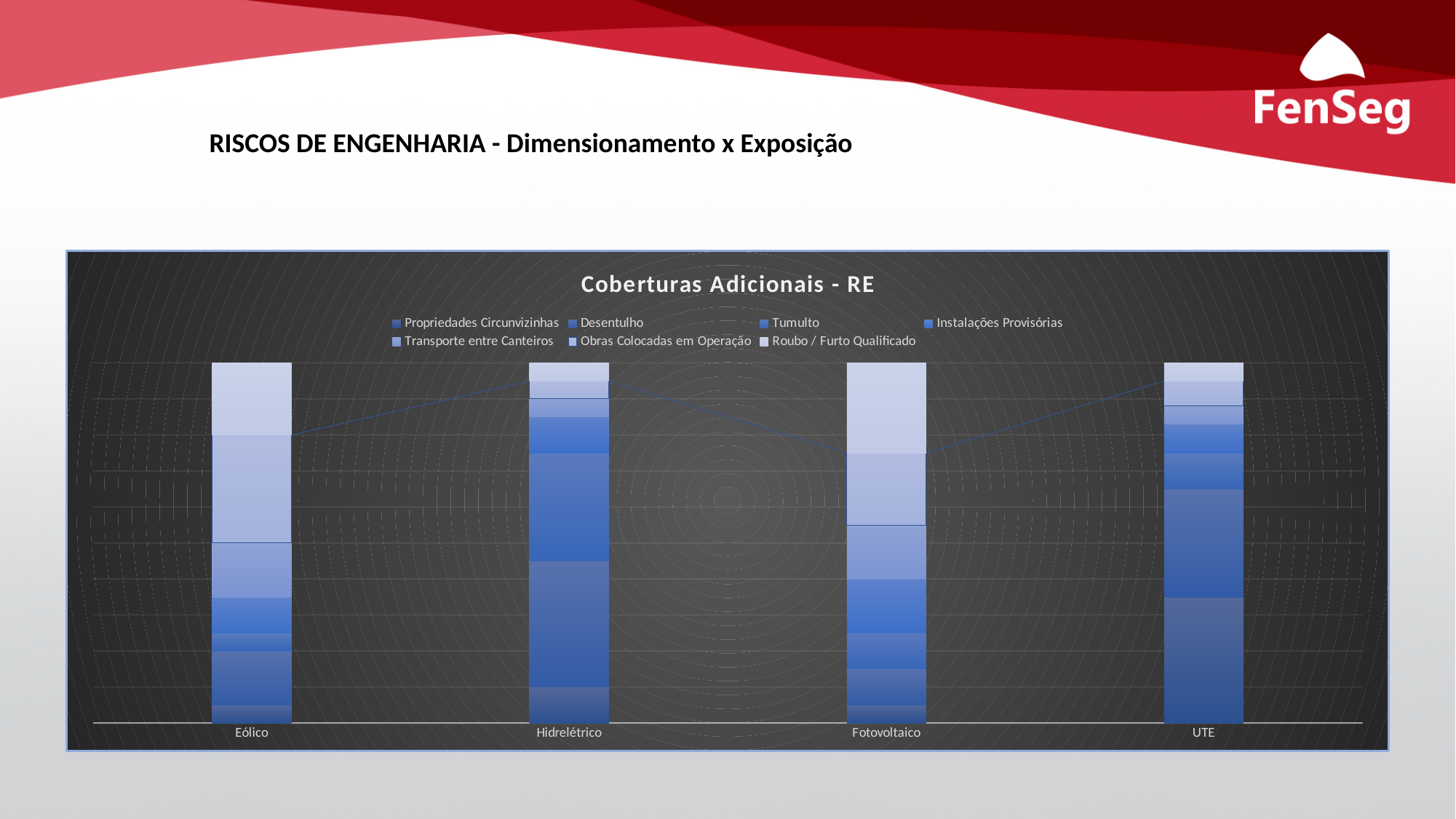
Which category is shown first (leftmost) on the x axis? Eólico How many series does the chart's legend list? 7 Is the Propriedades Circunvizinhas segment larger for UTE or for Eólico? UTE Is the Roubo / Furto Qualificado segment larger for Eólico or for Hidrelétrico? Eólico How many categories are shown along the x axis of the chart? 4 What kind of chart is shown on the slide? Stacked bar chart Which category has the largest share for Propriedades Circunvizinhas (the bottom segment of the stacked bars)? UTE What is the title of the chart? Coberturas Adicionais - RE Which category has the largest share for Roubo / Furto Qualificado (the top segment of the stacked bars)? Fotovoltaico